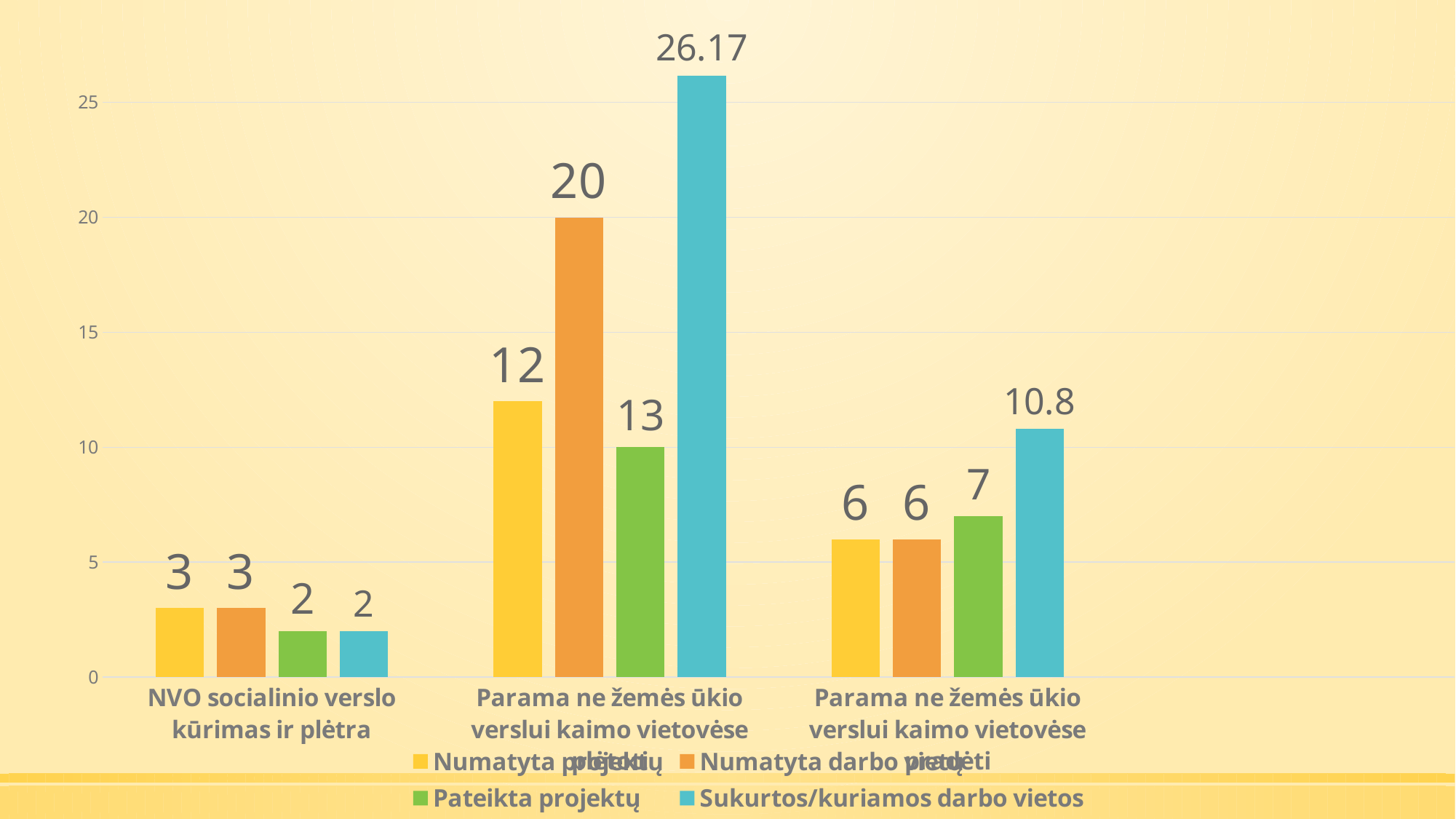
What is the value of Numatyta darbo vietų for the middle category? 20 In the rightmost category, which is larger: Pateikta projektų or Numatyta projektų? Pateikta projektų How many categories are shown on the x axis? 3 What is the difference between Sukurtos/kuriamos darbo vietos in the middle category and in the rightmost category? 15.37 What is the difference between Numatyta darbo vietų and Numatyta projektų in the middle category? 8 What is the value of Pateikta projektų for NVO socialinio verslo kūrimas ir plėtra? 2 What is the value of Sukurtos/kuriamos darbo vietos for the middle category (Parama ne žemės ūkio verslui kaimo vietovėse)? 26.17 Which series has the highest value in the middle category? Sukurtos/kuriamos darbo vietos What kind of chart is shown on the slide? bar chart What colour are the bars for Sukurtos/kuriamos darbo vietos? blue How many series does the legend list? 4 What is the value of Sukurtos/kuriamos darbo vietos for the rightmost category? 10.8